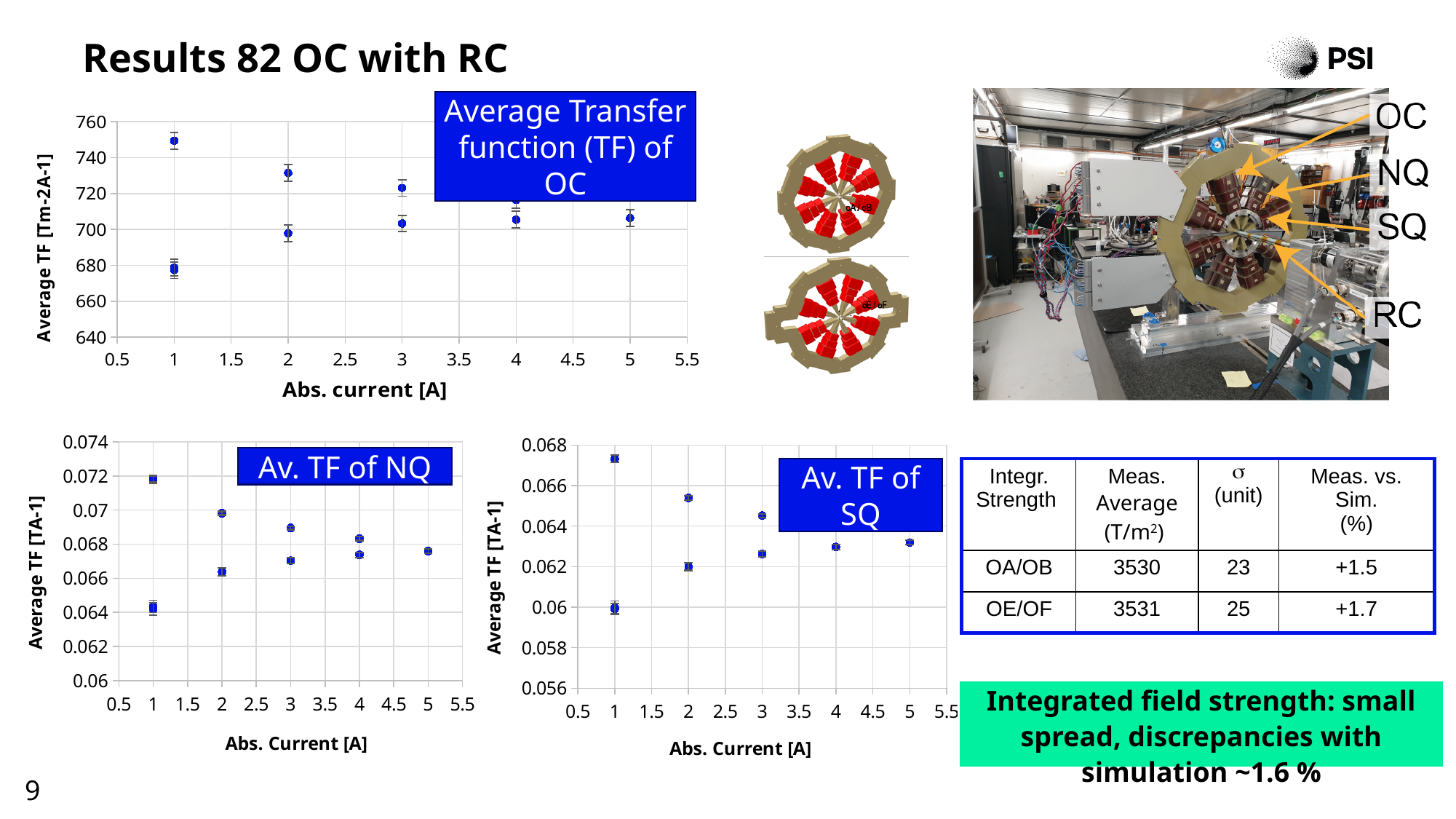
In the 'Average Transfer function (TF) of OC' chart, at which current is the highest point plotted? 1 A In the 'Average Transfer function (TF) of OC' chart, is the lower point at 1 A greater or less than 700? less What is the x-axis label of the 'Av. TF of SQ' chart? Abs. Current [A] In the 'Av. TF of NQ' chart, is the upper point at 1 A greater or less than 0.07? greater What kind of chart is the 'Average Transfer function (TF) of OC' chart? scatter chart In the 'Av. TF of NQ' chart, is the value at 5 A greater or less than 0.066? greater At how many different current values are points plotted in the 'Av. TF of NQ' chart? 5 In the 'Av. TF of SQ' chart, does the lower set of points rise or fall as the current increases from 1 A to 5 A? rise In the 'Average Transfer function (TF) of OC' chart, does the upper set of points rise or fall as the current increases from 1 A to 5 A? fall